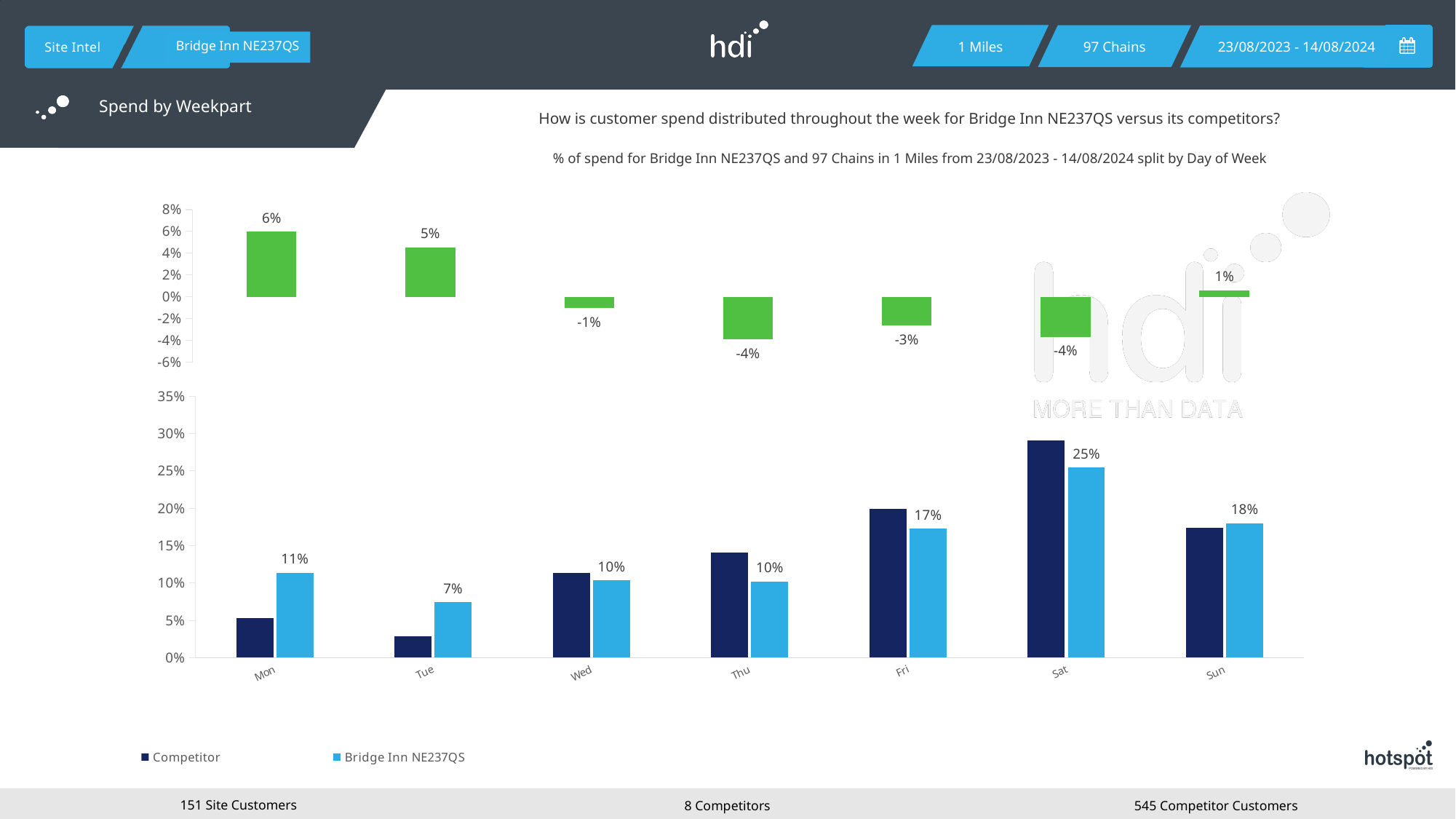
In the bottom bar chart, is the Competitor value for Tue greater or less than 5%? less In the bottom bar chart, what is the value for Bridge Inn NE237QS on Tue? 7% How many days of the week are shown on the x axis of the bottom bar chart? 7 In the bottom bar chart, is the Competitor value for Sat greater or less than 25%? greater In the bottom bar chart, on which day is the Bridge Inn NE237QS value lowest? Tue In the bottom bar chart, on which day is the Bridge Inn NE237QS value highest? Sat In the bottom bar chart, what is the difference between the Bridge Inn NE237QS values for Sat and Sun? 7% In the bottom bar chart, which is larger on Fri: the Competitor value or the Bridge Inn NE237QS value? Competitor How many series does the legend of the bottom bar chart list? 2 In the bottom bar chart, what is the value for Bridge Inn NE237QS on Sat? 25% In the top chart, what is the value shown for Mon? 6% In the top chart, what is the value shown for Thu? -4%